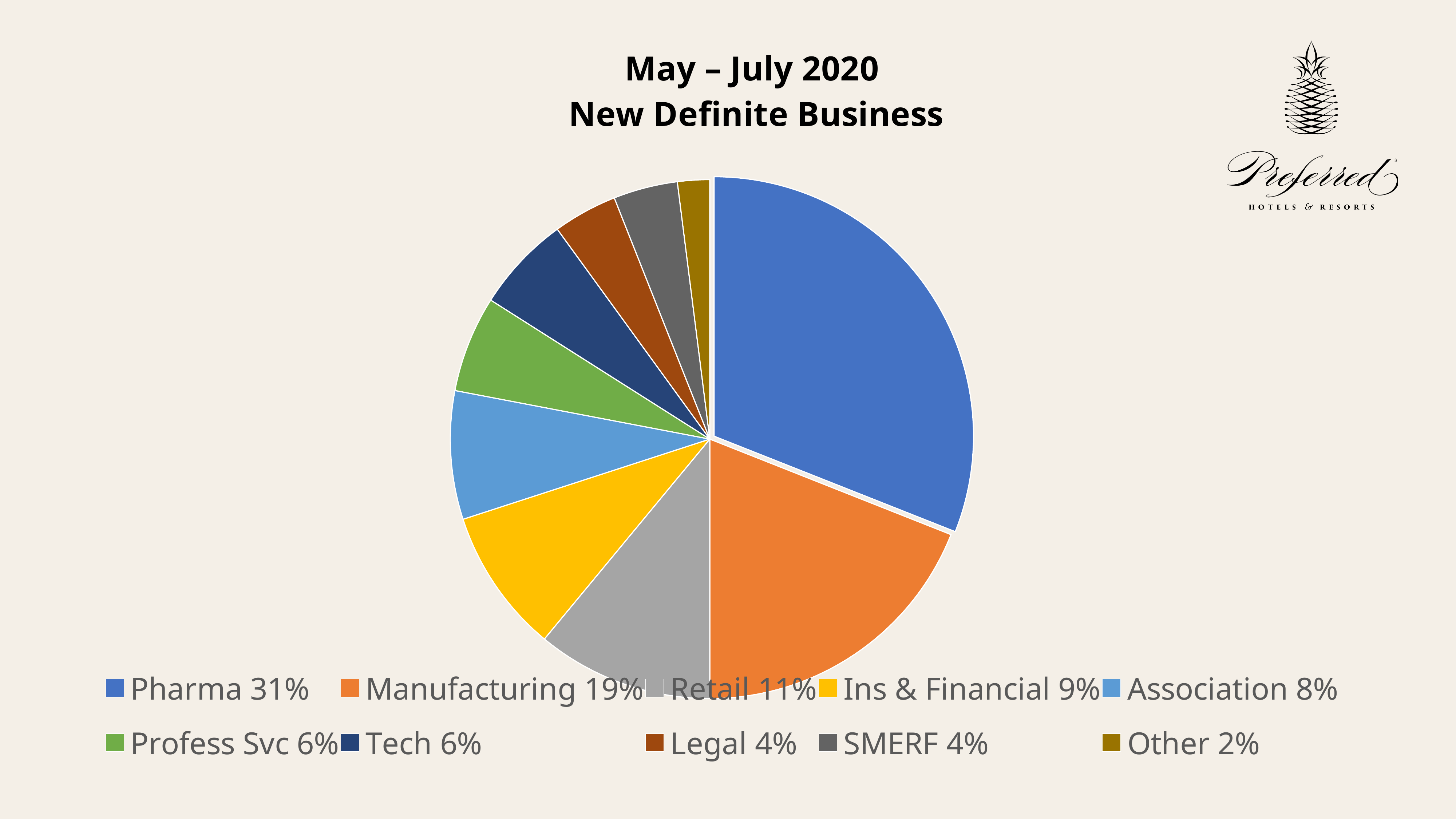
What share of the pie does Manufacturing hold? 19% What is the value for Association? 8% How many categories does the pie chart show? 10 Which category has the largest share of the pie? Pharma What is the difference between the Pharma and Manufacturing shares? 12% What is the value for Retail? 11% What kind of chart is shown on the slide? Pie chart What is the value for Ins & Financial? 9% What share of the pie does Pharma hold? 31% Which category has the smallest share of the pie? Other What is the title of the chart? May – July 2020 New Definite Business Which is larger, the share for Retail or the share for Association? Retail